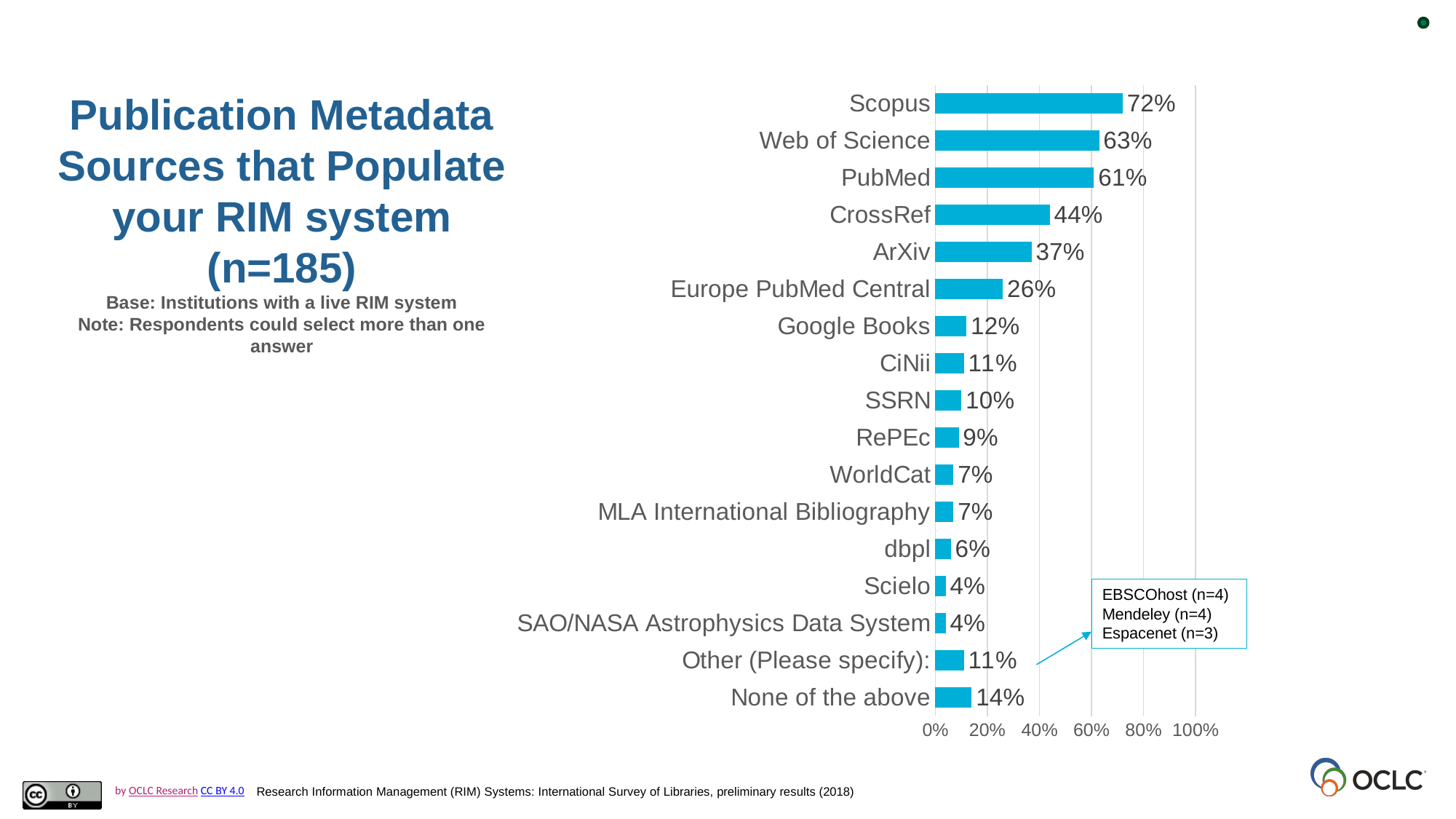
Which publication metadata source has the highest percentage? Scopus Which has a higher percentage, Google Books or RePEc? Google Books What is the difference in percentage points between Scopus and Web of Science? 9 What percentage of respondents selected Scopus as a publication metadata source? 72% Is the value for Web of Science greater or less than 60%? greater According to the callout box, how many respondents specified Espacenet under Other? 3 What percentage is shown for None of the above? 14% What is the value shown for Europe PubMed Central? 26% How many categories (bars) are shown in the chart? 17 What is the difference in percentage points between CrossRef and ArXiv? 7 What kind of chart is shown on the slide? Bar chart Which has a higher percentage, PubMed or CrossRef? PubMed